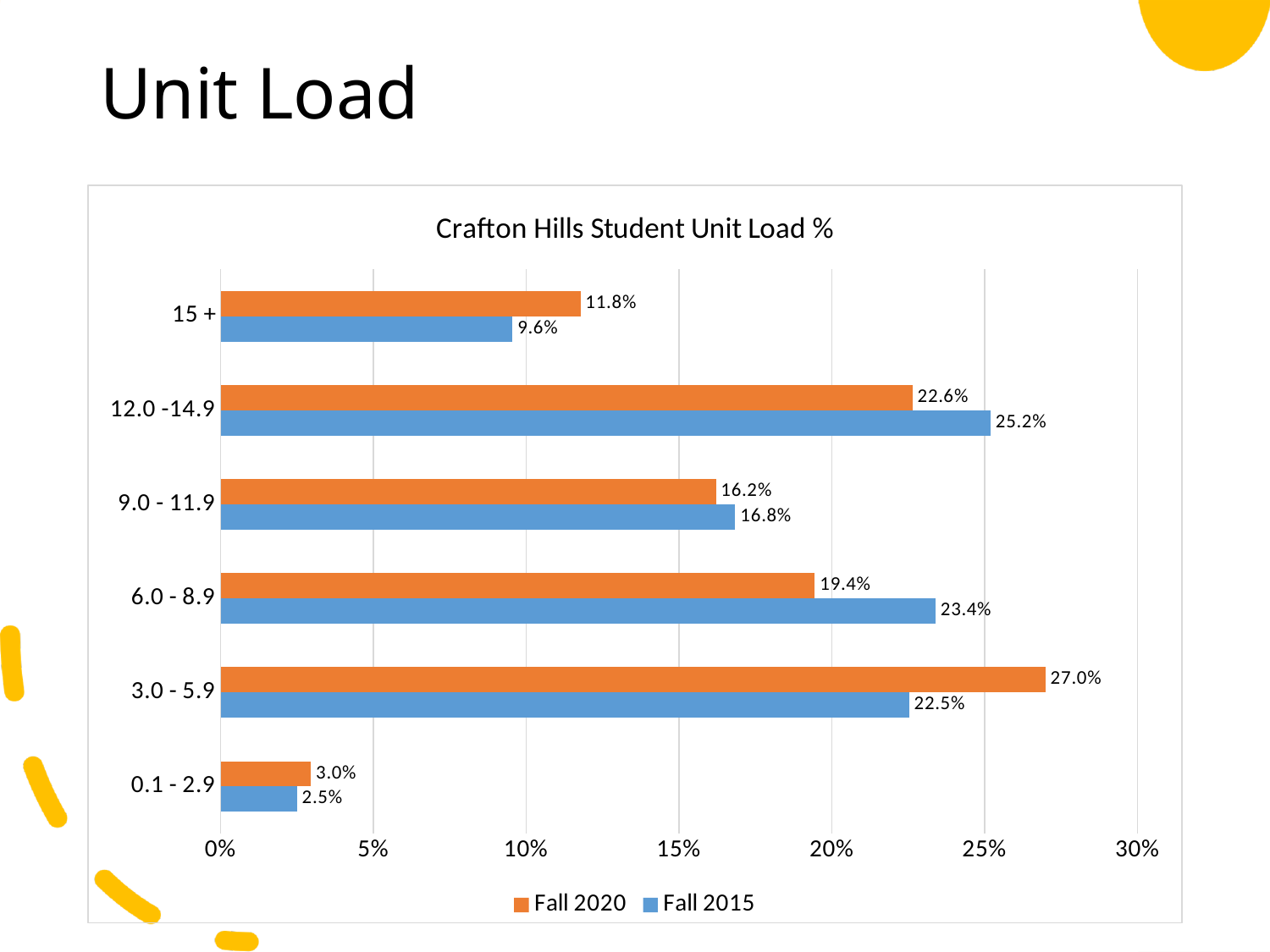
What is the difference between the Fall 2015 and Fall 2020 values for the 6.0 - 8.9 category? 4.0% Is the Fall 2020 value for the 12.0 -14.9 category greater or less than 20%? greater How many series does the legend list? 2 What is the Fall 2020 value for the 3.0 - 5.9 unit load category? 27.0% How many unit load categories are shown on the chart? 6 What is the Fall 2015 value for the 15 + unit load category? 9.6% What is the Fall 2015 value for the 12.0 -14.9 unit load category? 25.2% For the 9.0 - 11.9 category, which is larger: the Fall 2020 value or the Fall 2015 value? Fall 2015 What kind of chart is shown on the slide? Bar chart Which unit load category has the highest Fall 2020 value? 3.0 - 5.9 Which unit load category has the lowest Fall 2015 value? 0.1 - 2.9 What is the title of the chart? Crafton Hills Student Unit Load %